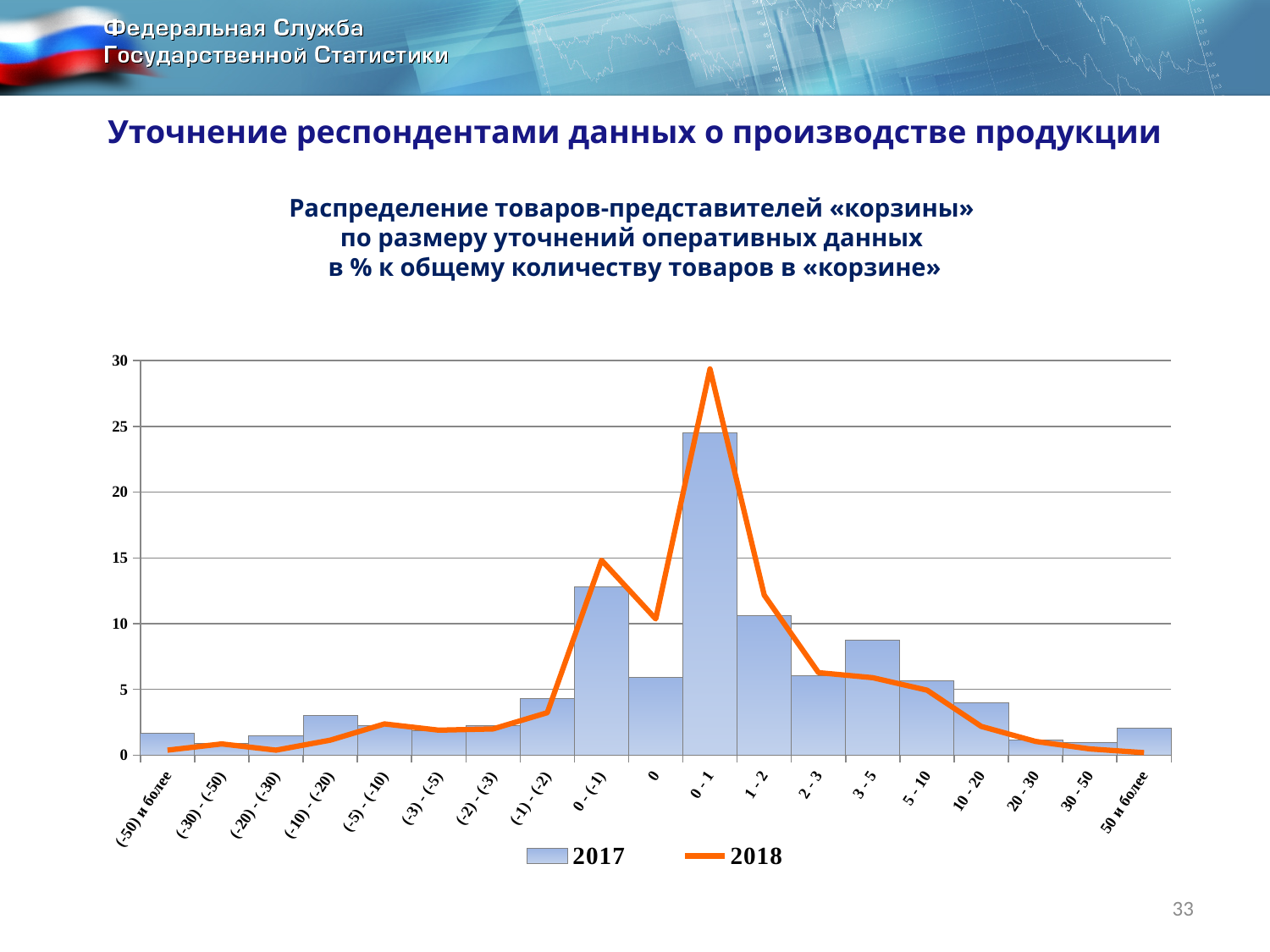
Is the 2017 value for "0 - (-1)" greater or less than 10? greater Is the 2017 value for "10 - 20" greater or less than 5? less How many categories are shown along the x axis? 19 How many series does the legend list? 2 What kind of chart is shown on the slide? A combined bar and line chart Is the 2017 value for "0 - 1" greater or less than 20? greater Which category has the highest value for 2018? 0 - 1 Which category has the highest value for 2017? 0 - 1 For the category "0 - 1", which series has the larger value, 2017 or 2018? 2018 Which series is drawn as a line in the chart? 2018 Which is larger for 2017: the value for "3 - 5" or the value for "5 - 10"? 3 - 5